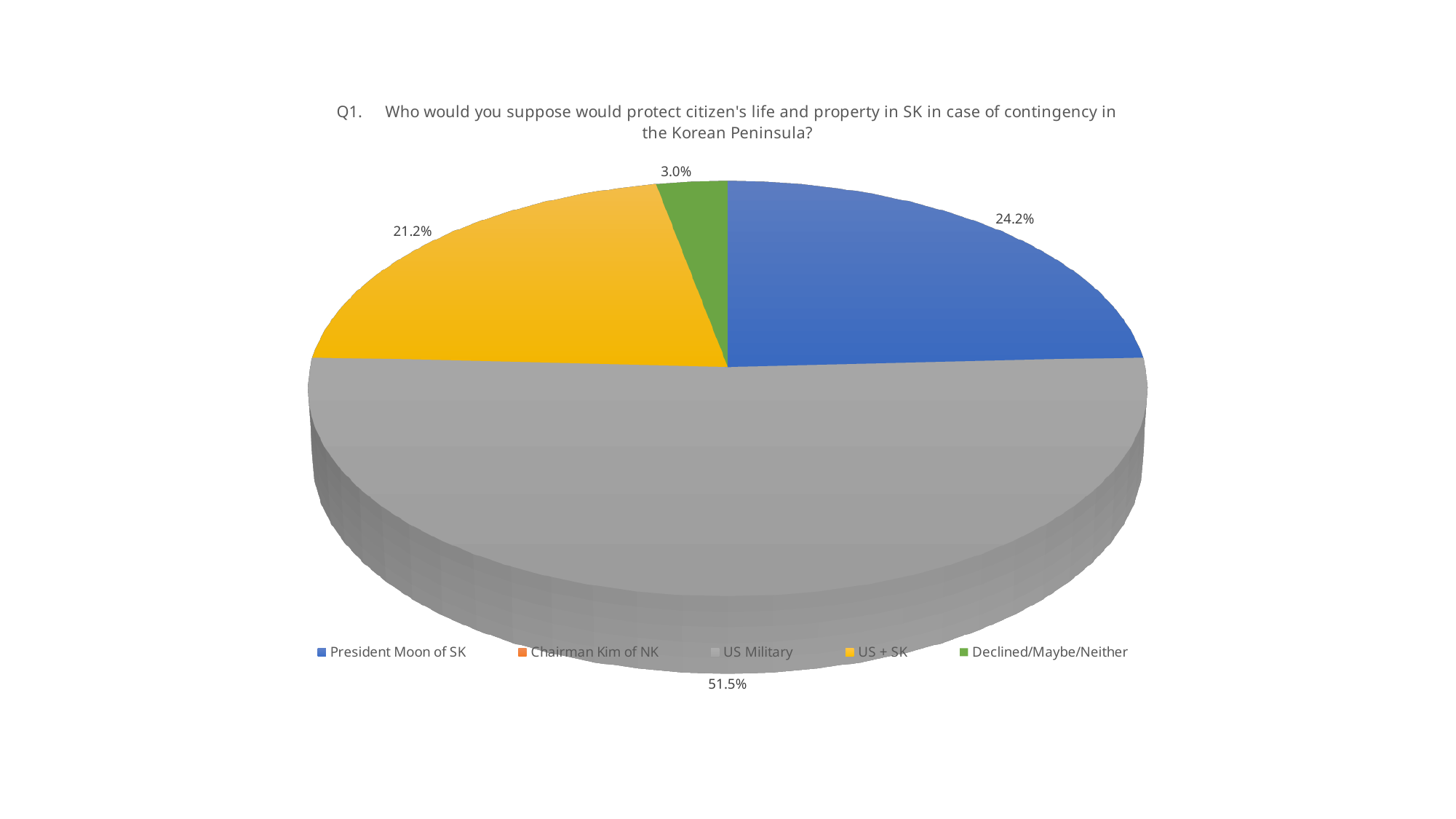
What percentage of respondents chose US + SK? 21.2% How many categories does the legend list? 5 Which is larger, the share for President Moon of SK or the share for US + SK? President Moon of SK What percentage of respondents chose Declined/Maybe/Neither? 3.0% What is the difference in percentage points between the US Military share and the President Moon of SK share? 27.3 percentage points Which colour represents US + SK in the chart? Yellow Is the share for US Military greater or less than 50%? greater What is the difference in percentage points between the President Moon of SK share and the US + SK share? 3.0 percentage points What percentage of respondents chose US Military? 51.5% What percentage of respondents chose President Moon of SK? 24.2% Which category has the largest share of the pie? US Military What kind of chart is shown on the slide? Pie chart